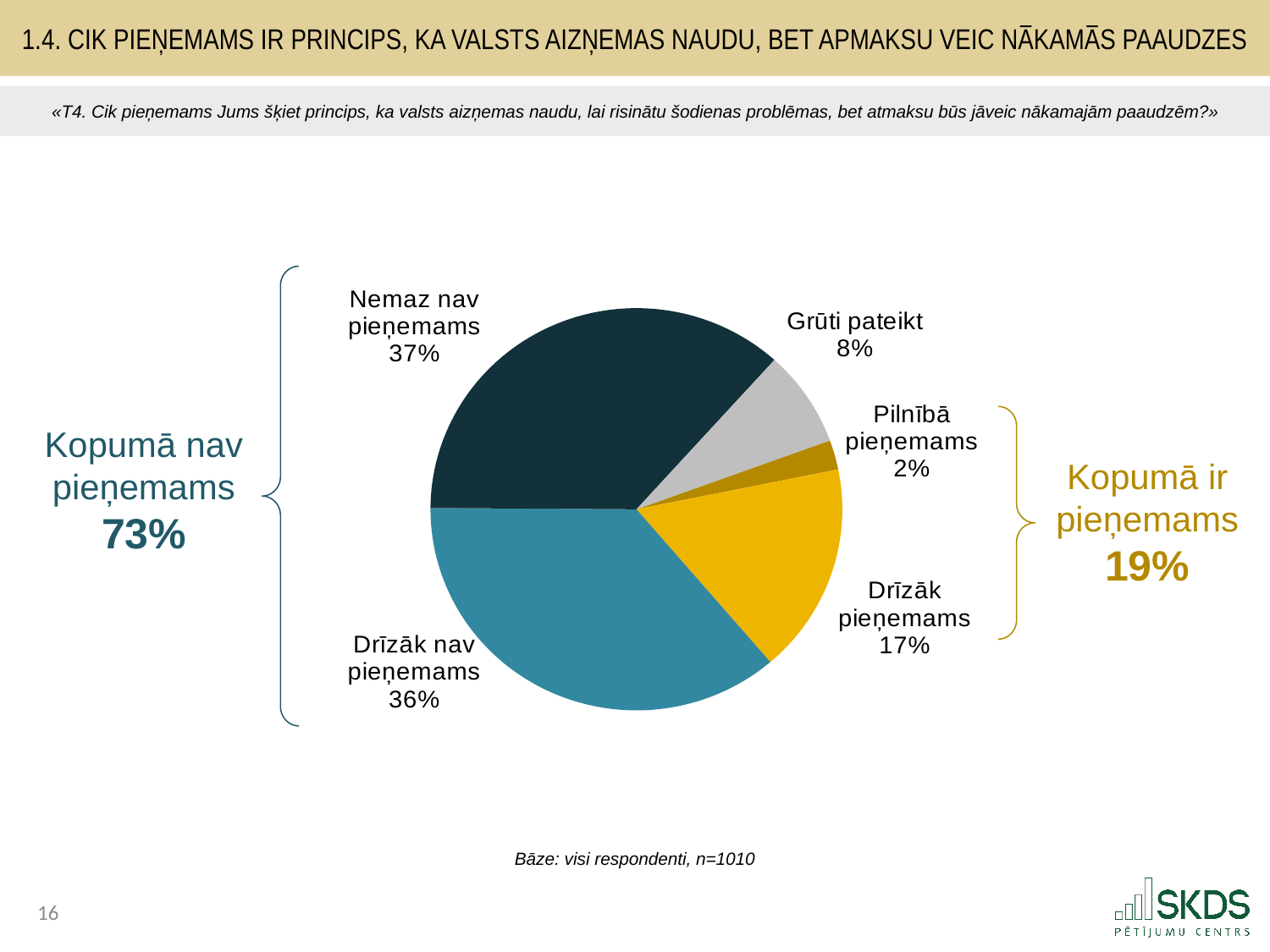
Which is larger: the share for "Grūti pateikt" or the share for "Pilnībā pieņemams"? Grūti pateikt What share of respondents answered "Nemaz nav pieņemams"? 37% What share of respondents answered "Grūti pateikt"? 8% What is the difference between the shares for "Drīzāk nav pieņemams" and "Drīzāk pieņemams"? 19 percentage points Which category has the smallest slice of the pie? Pilnībā pieņemams What share of respondents answered "Pilnībā pieņemams"? 2% What kind of chart is shown on the slide? pie chart Which category has the largest slice of the pie? Nemaz nav pieņemams How many slices does the pie chart have? 5 What share of respondents answered "Drīzāk pieņemams"? 17% What combined share is shown for "Kopumā nav pieņemams"? 73% What combined share is shown for "Kopumā ir pieņemams"? 19%